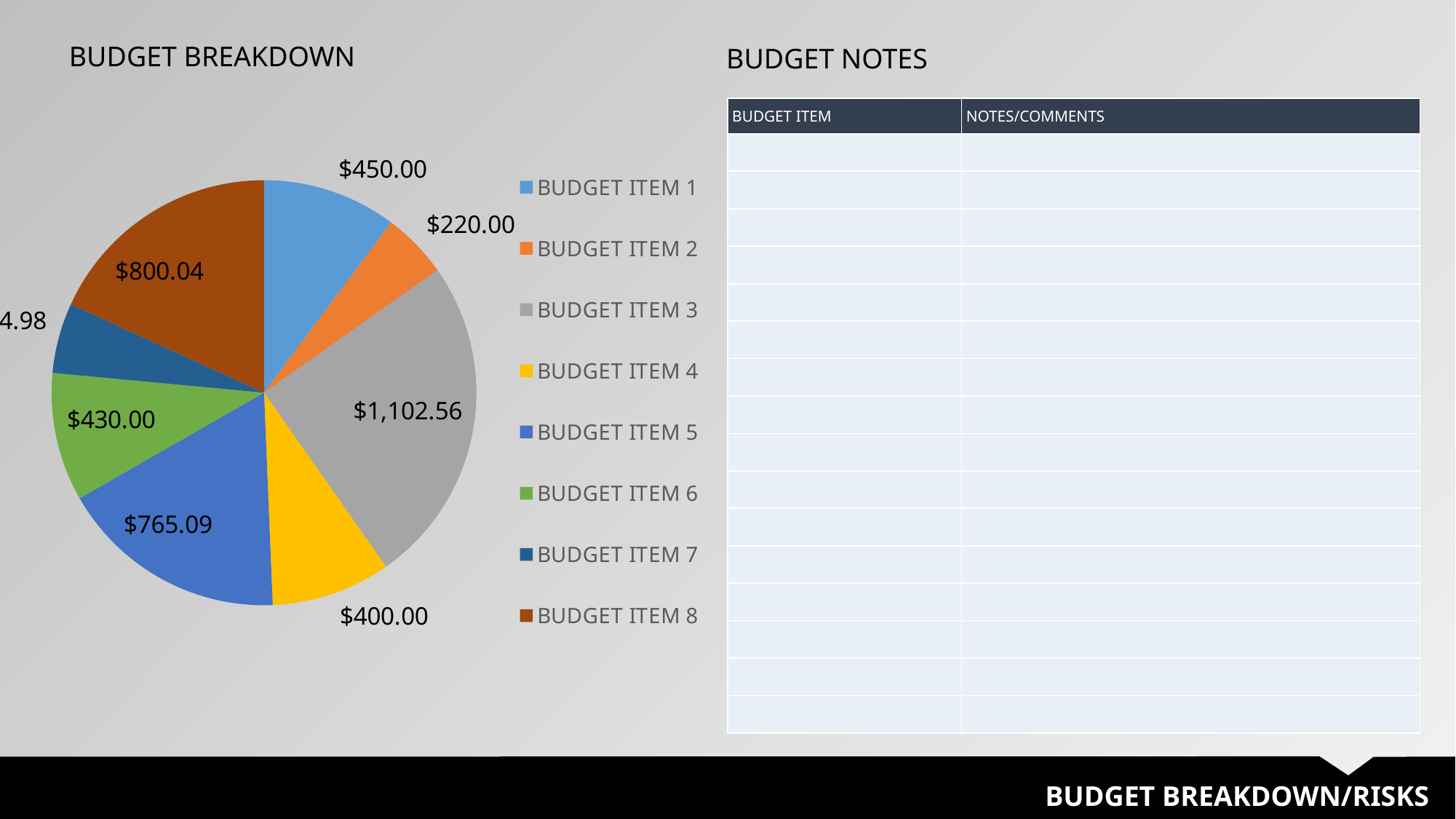
In the BUDGET BREAKDOWN pie chart, what colour is the slice for BUDGET ITEM 4? Yellow In the BUDGET BREAKDOWN pie chart, what is the difference between BUDGET ITEM 1 and BUDGET ITEM 4? $50.00 In the BUDGET BREAKDOWN pie chart, what is the value for BUDGET ITEM 3? $1,102.56 In the BUDGET BREAKDOWN pie chart, what is the value for BUDGET ITEM 2? $220.00 Which budget item has the largest slice in the BUDGET BREAKDOWN pie chart? BUDGET ITEM 3 In the BUDGET BREAKDOWN pie chart, what is the value for BUDGET ITEM 1? $450.00 What type of chart is shown under the title BUDGET BREAKDOWN? Pie chart In the BUDGET BREAKDOWN pie chart, what is the value for BUDGET ITEM 5? $765.09 In the BUDGET BREAKDOWN pie chart, what is the value for BUDGET ITEM 8? $800.04 In the BUDGET BREAKDOWN pie chart, which is larger: BUDGET ITEM 8 or BUDGET ITEM 5? BUDGET ITEM 8 How many budget items does the legend of the BUDGET BREAKDOWN pie chart list? 8 In the BUDGET BREAKDOWN pie chart, what is the difference between BUDGET ITEM 3 and BUDGET ITEM 8? $302.52